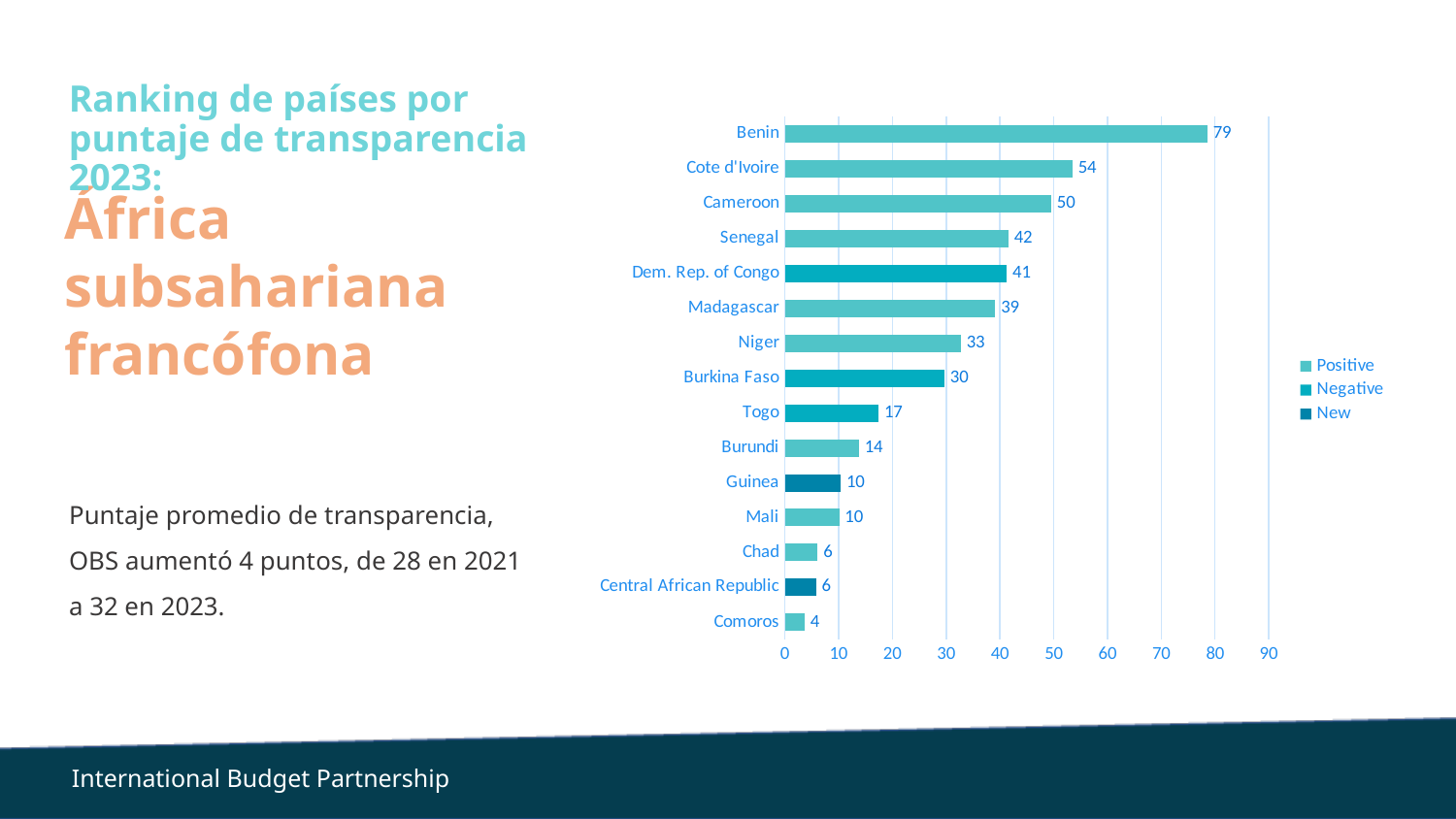
What is the difference between the scores of Benin and Comoros? 75 What is the transparency score for Dem. Rep. of Congo? 41 What is the transparency score for Benin? 79 What kind of chart is shown on the slide? Bar chart Which has a higher score, Senegal or Madagascar? Senegal Which country has the highest transparency score? Benin How many countries are shown in the chart? 15 What is the difference between the scores of Cote d'Ivoire and Cameroon? 4 How many series does the legend list? 3 What are the three legend entries of the chart? Positive, Negative, New What is the transparency score for Central African Republic? 6 Which country has the lowest transparency score? Comoros